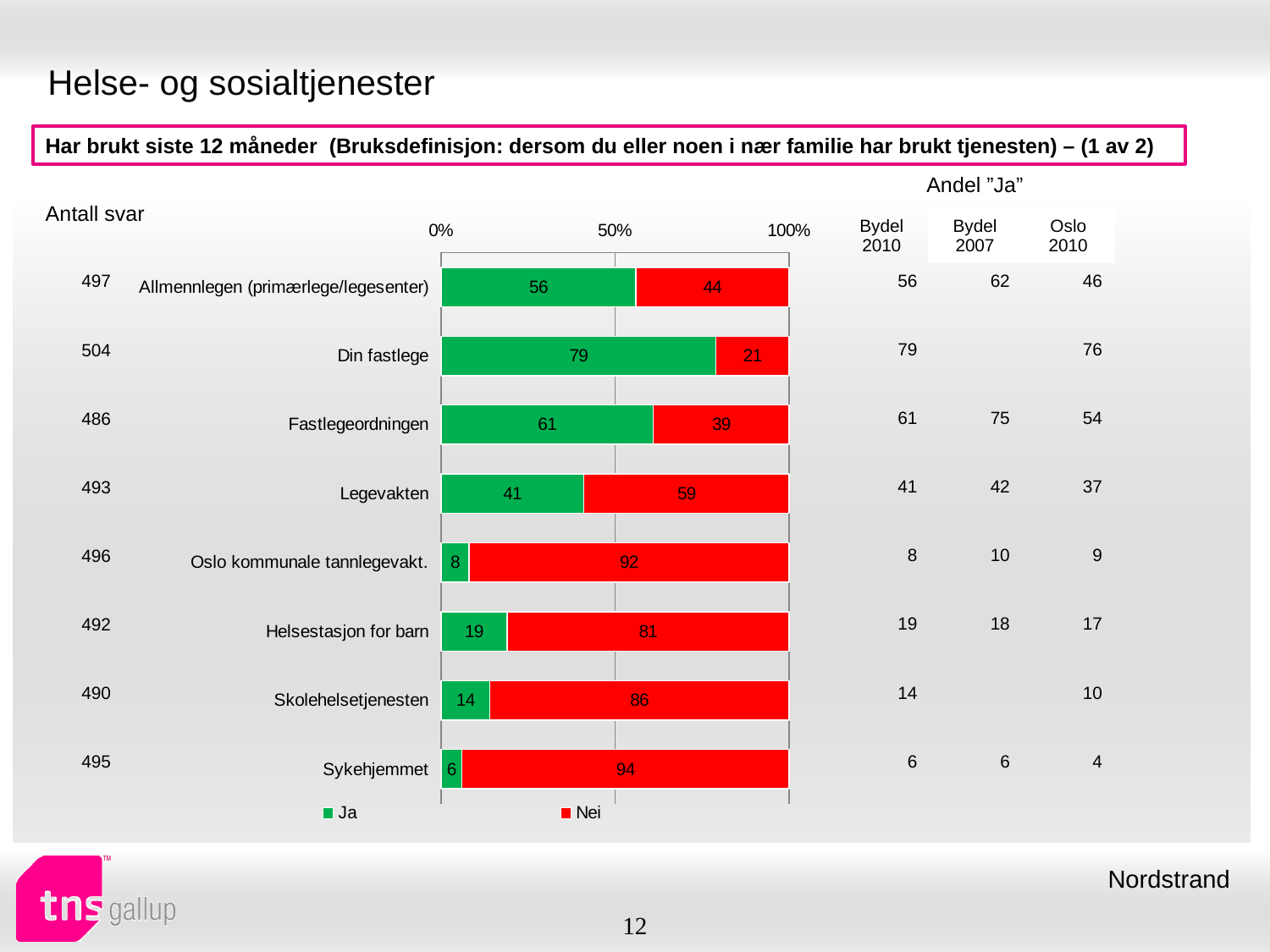
What is the 'Ja' value for Din fastlege? 79 Which colour represents 'Nei' in the chart? Red What is the total of the stacked bar for Oslo kommunale tannlegevakt.? 100 How many categories are shown in the chart? 8 How many series does the legend list? 2 What is the difference between the 'Ja' values for Fastlegeordningen and Legevakten? 20 What kind of chart is shown? Stacked bar chart Which category has the highest 'Ja' value? Din fastlege What is the 'Nei' value for Allmennlegen (primærlege/legesenter)? 44 Which category has the lowest 'Ja' value? Sykehjemmet Which is larger, the 'Ja' value for Helsestasjon for barn or for Skolehelsetjenesten? Helsestasjon for barn What is the 'Nei' value for Legevakten? 59